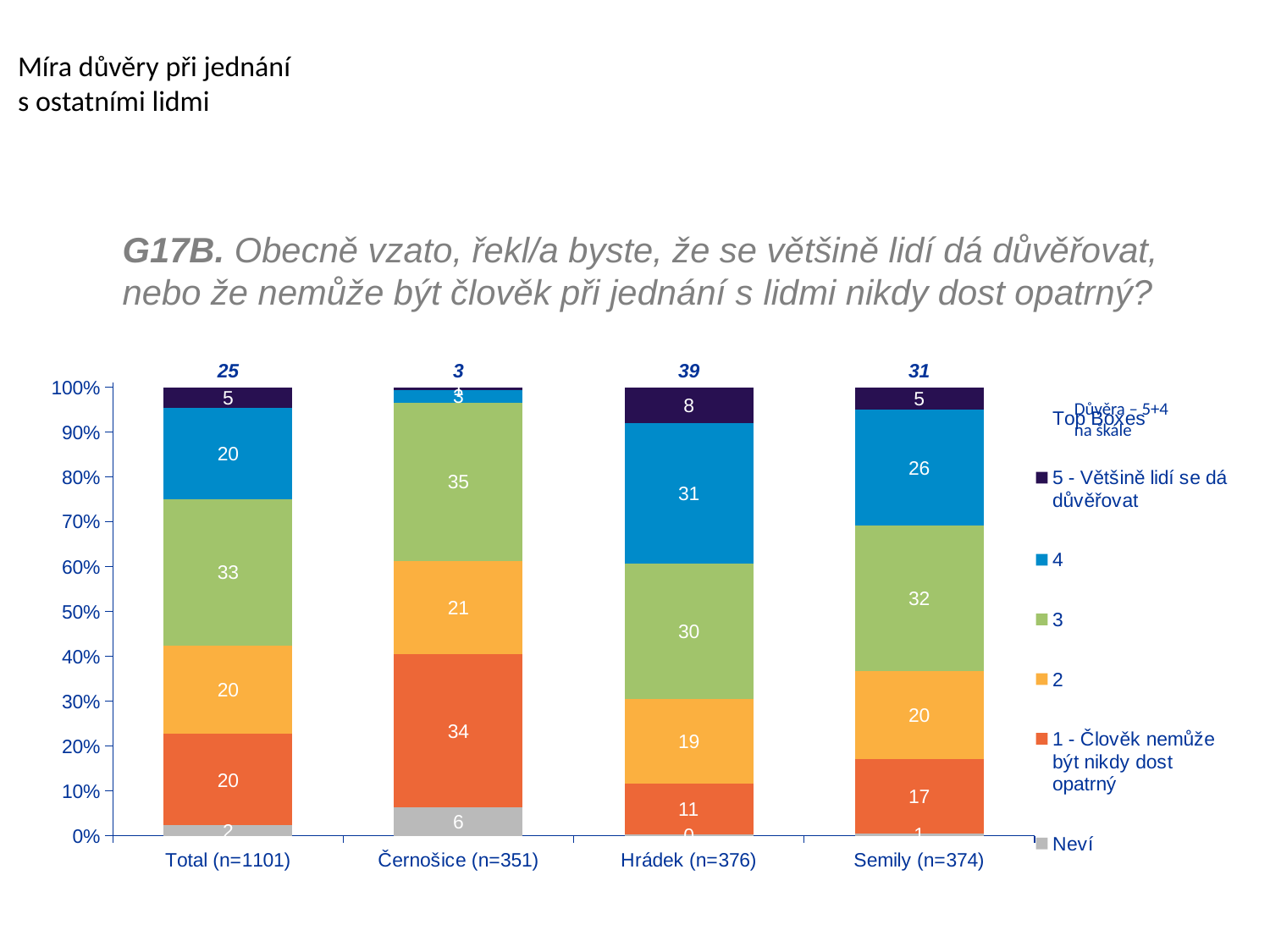
Which category has the lowest Top Boxes value shown above the bars? Černošice (n=351) What is the value of the '5 - Většině lidí se dá důvěřovat' segment for Semily (n=374)? 5 What is the difference between the '4' segment values for Hrádek (n=376) and Semily (n=374)? 5 What kind of chart is shown on the slide? Stacked bar chart What is the value of the '3' segment for Total (n=1101)? 33 What is the value of the '1 - Člověk nemůže být nikdy dost opatrný' segment for Černošice (n=351)? 34 What is the Top Boxes value shown above the bar for Hrádek (n=376)? 39 Which is larger: the '2' segment for Černošice (n=351) or the '2' segment for Hrádek (n=376)? Černošice (n=351) What is the value of the '4' segment for Hrádek (n=376)? 31 How many series does the legend list? 7 How many categories are shown on the x axis? 4 Which category has the highest Top Boxes value shown above the bars? Hrádek (n=376)